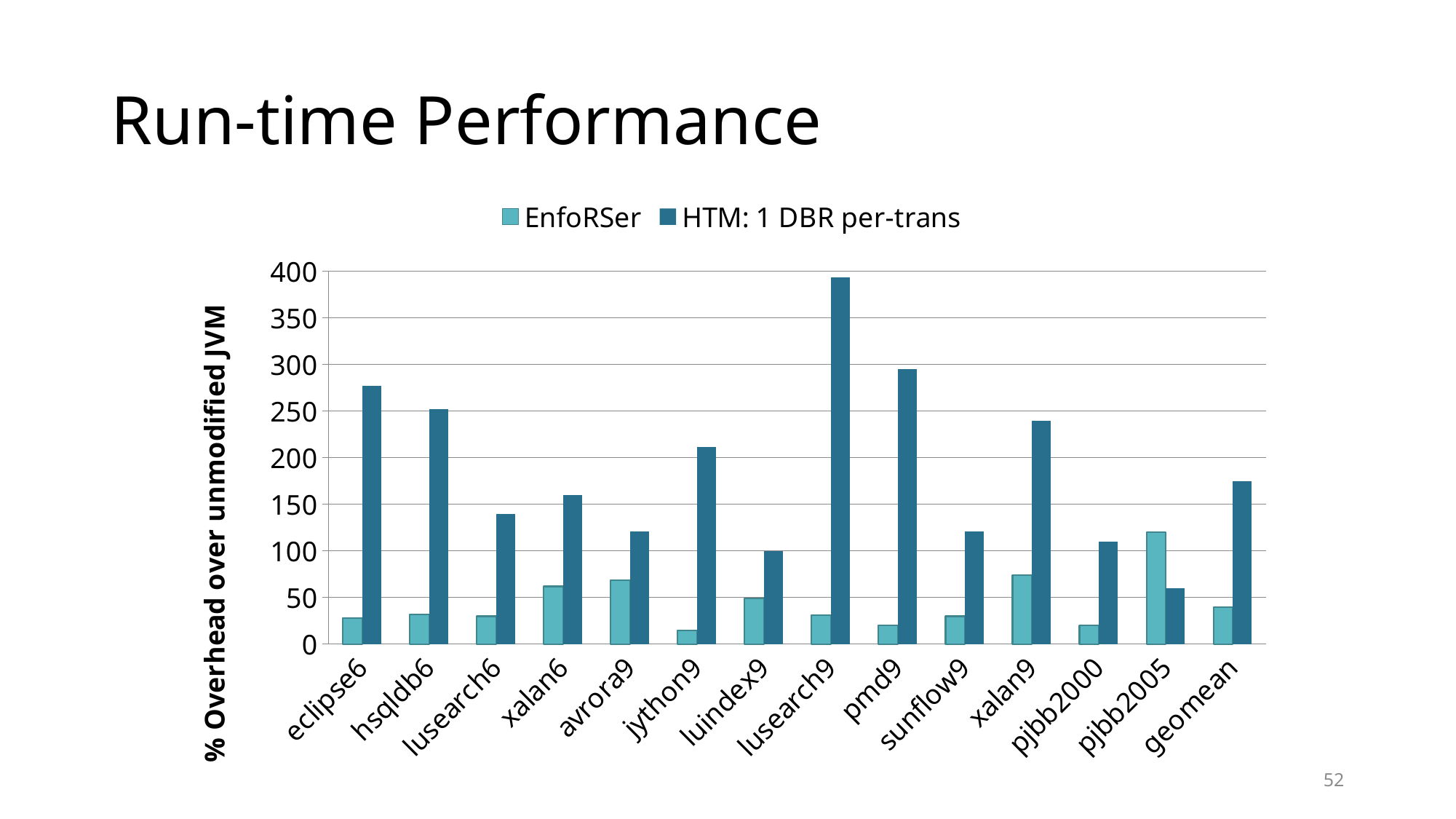
Which category has the lowest value for the EnfoRSer series? jython9 For pjbb2005, which series has the larger value, EnfoRSer or HTM: 1 DBR per-trans? EnfoRSer Is the HTM: 1 DBR per-trans value for lusearch9 greater or less than 350? greater Which category has the highest value for the EnfoRSer series? pjbb2005 Is the EnfoRSer value for pjbb2005 greater or less than 100? greater Which category has the lowest value for the HTM: 1 DBR per-trans series? pjbb2005 What kind of chart is shown on the slide? bar chart What is the label of the y axis? % Overhead over unmodified JVM How many series does the legend list? 2 Which category has the highest value for the HTM: 1 DBR per-trans series? lusearch9 How many benchmark categories are shown on the x axis? 14 Is the HTM: 1 DBR per-trans value for eclipse6 greater or less than 250? greater